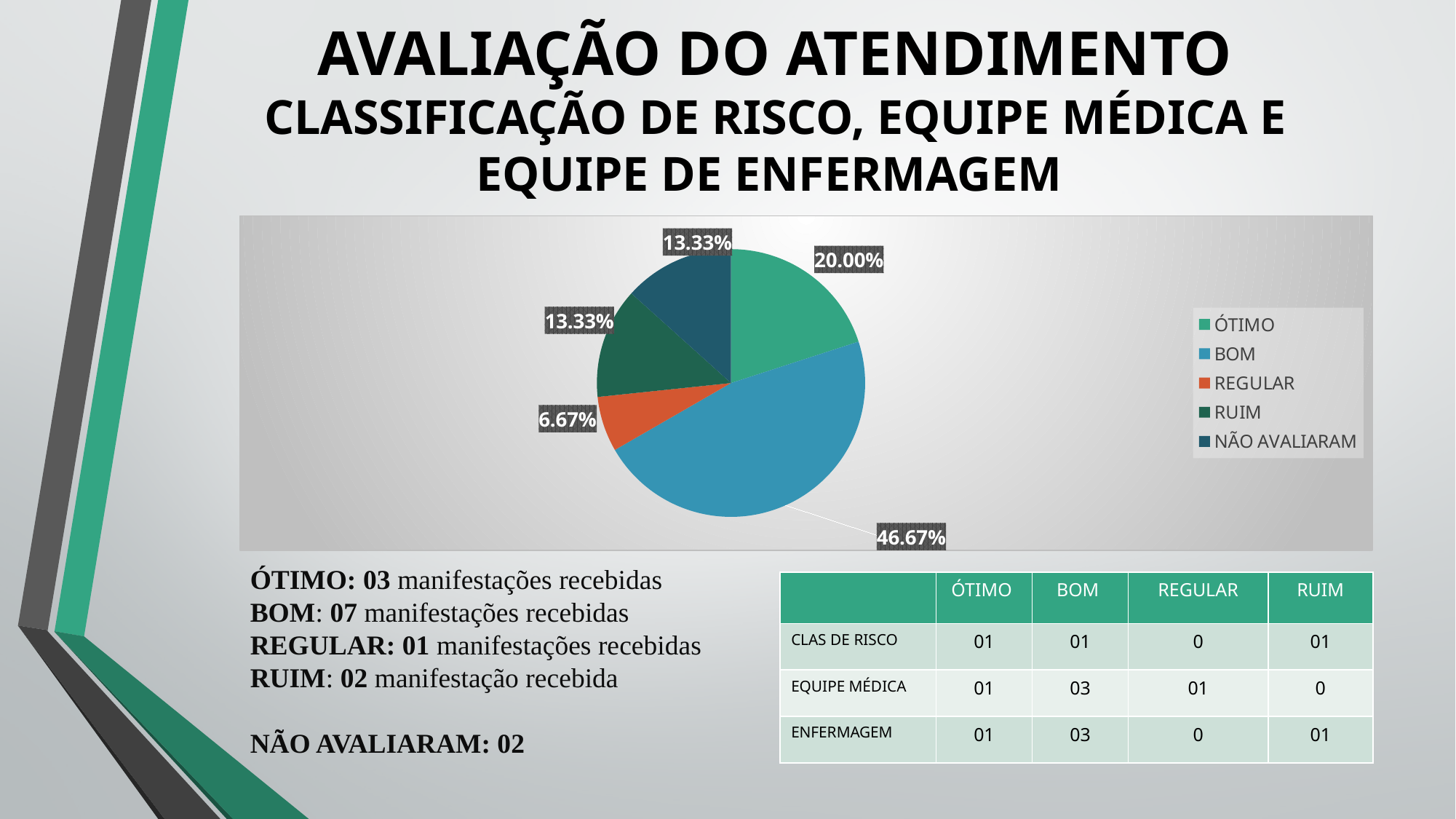
What kind of chart is shown on the slide? pie chart Which category has the largest slice of the pie? BOM How many entries does the legend of the pie chart list? 5 What share of the pie does BOM represent? 46.67% Which category has the smallest slice of the pie? REGULAR What share of the pie does NÃO AVALIARAM represent? 13.33% How many slices does the pie chart have? 5 What is the difference in percentage points between the BOM slice and the ÓTIMO slice? 26.67 What share of the pie does RUIM represent? 13.33% Which slice is larger, ÓTIMO or REGULAR? ÓTIMO What share of the pie does REGULAR represent? 6.67% What share of the pie does ÓTIMO represent? 20.00%